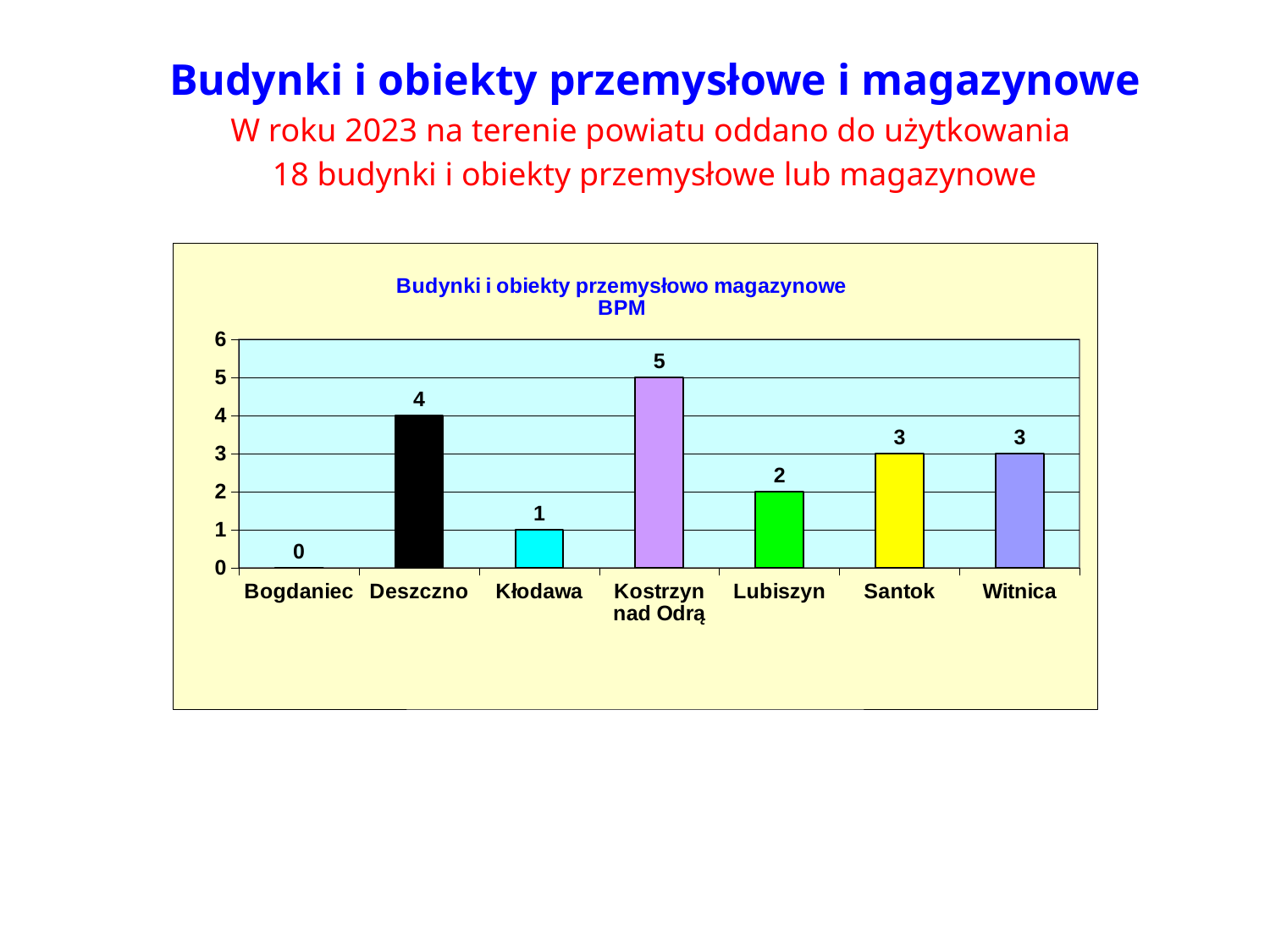
Which category has the highest value? Kostrzyn nad Odrą Which is larger, the value for Deszczno or the value for Santok? Deszczno What is the value for Lubiszyn? 2 What is the title of the chart? Budynki i obiekty przemysłowo magazynowe BPM Which category has the lowest value? Bogdaniec How many categories are shown on the x axis? 7 What is the difference between the values for Kostrzyn nad Odrą and Kłodawa? 4 What is the value for Bogdaniec? 0 What is the value for Kostrzyn nad Odrą? 5 What kind of chart is shown? bar chart What colour is the bar for Santok? yellow What is the value for Deszczno? 4